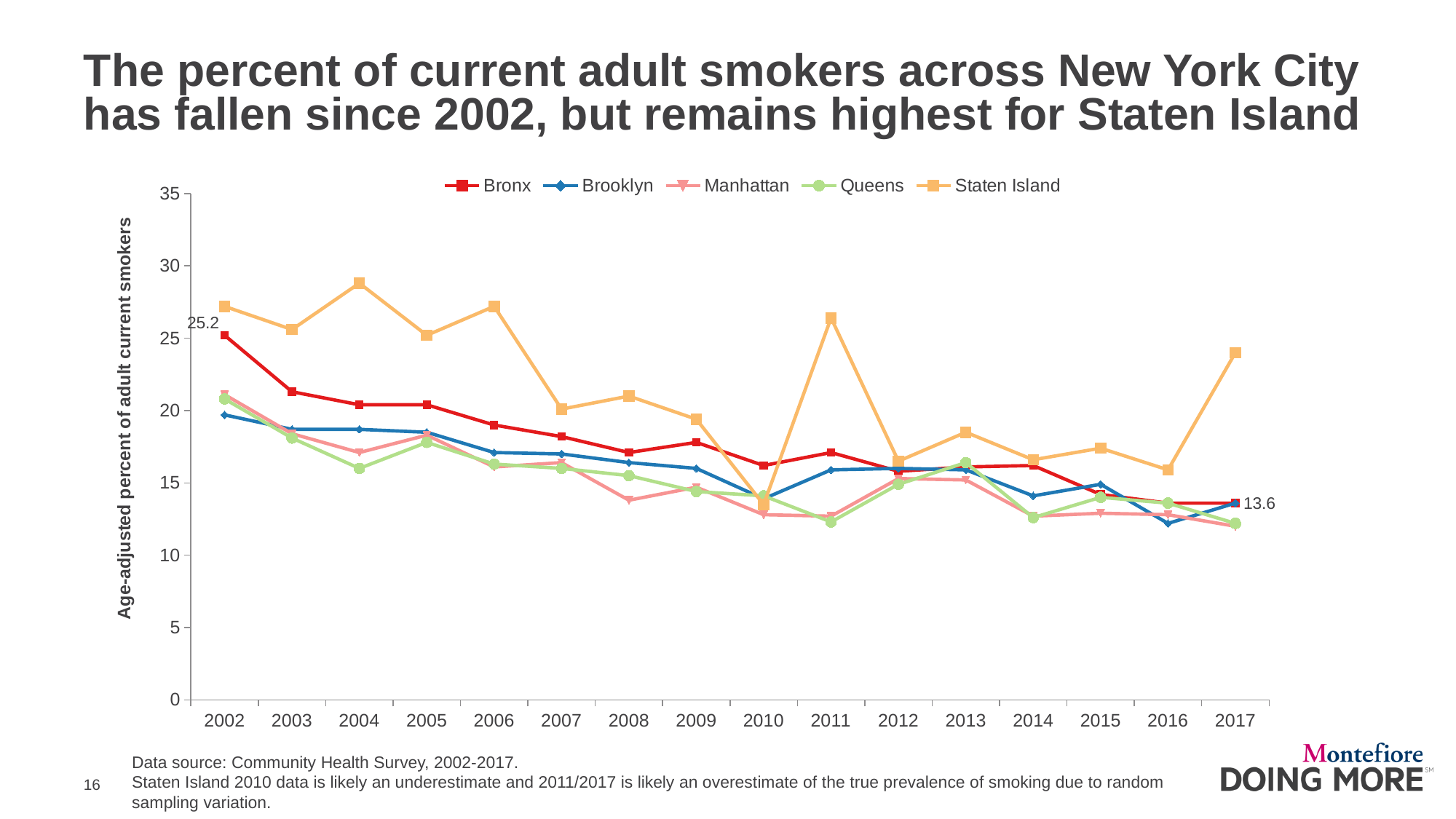
Is the value for Staten Island in 2004 greater or less than 25? greater Does the Bronx line generally rise or fall from 2002 to 2017? fall Which borough has the lowest value in 2004? Queens How many series does the legend list? 5 Which borough has the highest value in 2004? Staten Island What type of chart is shown on the slide? line chart By how much did the Bronx value fall from 2002 (25.2) to 2017 (13.6)? 11.6 How many years are shown along the x axis? 16 In 2006, which is larger: the value for the Bronx or the value for Queens? Bronx Is the value for Queens in 2011 greater or less than 15? less What is the labeled value for the Bronx in 2002? 25.2 What is the labeled value for the Bronx in 2017? 13.6